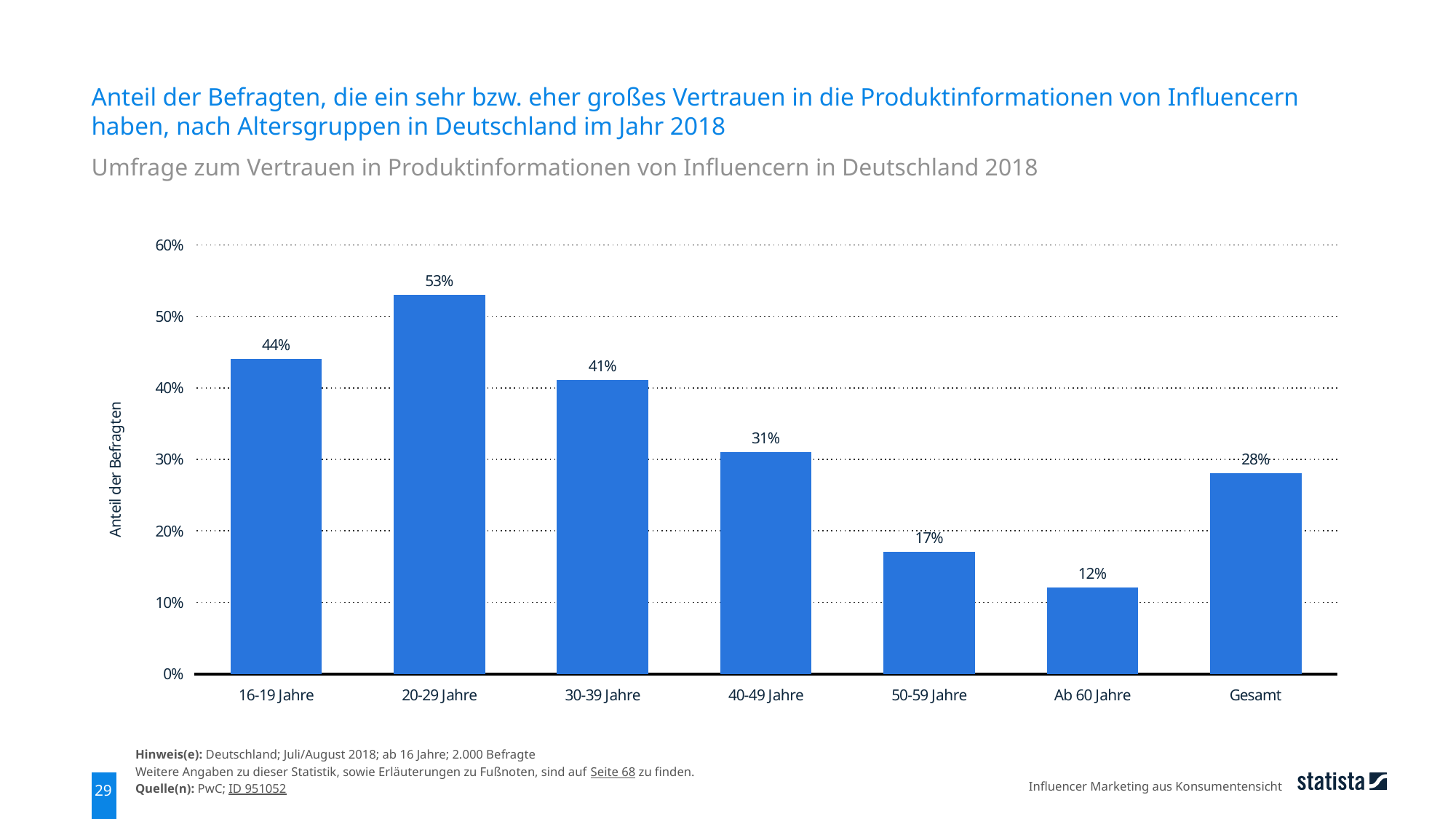
Is the value for 40-49 Jahre greater or less than 30%? greater What is the value for Gesamt? 28% How many categories are shown on the x axis? 7 Which category has the lowest share? Ab 60 Jahre What is the value for the Ab 60 Jahre age group? 12% Do the values rise or fall from the 20-29 Jahre group to the Ab 60 Jahre group? Fall What is the difference between the values for 16-19 Jahre and 50-59 Jahre? 27 percentage points Which age group has the highest share? 20-29 Jahre What is the value for the 20-29 Jahre age group? 53% Which is larger, the value for 30-39 Jahre or the value for 40-49 Jahre? 30-39 Jahre What kind of chart is shown on the slide? Bar chart What is the label of the y axis? Anteil der Befragten